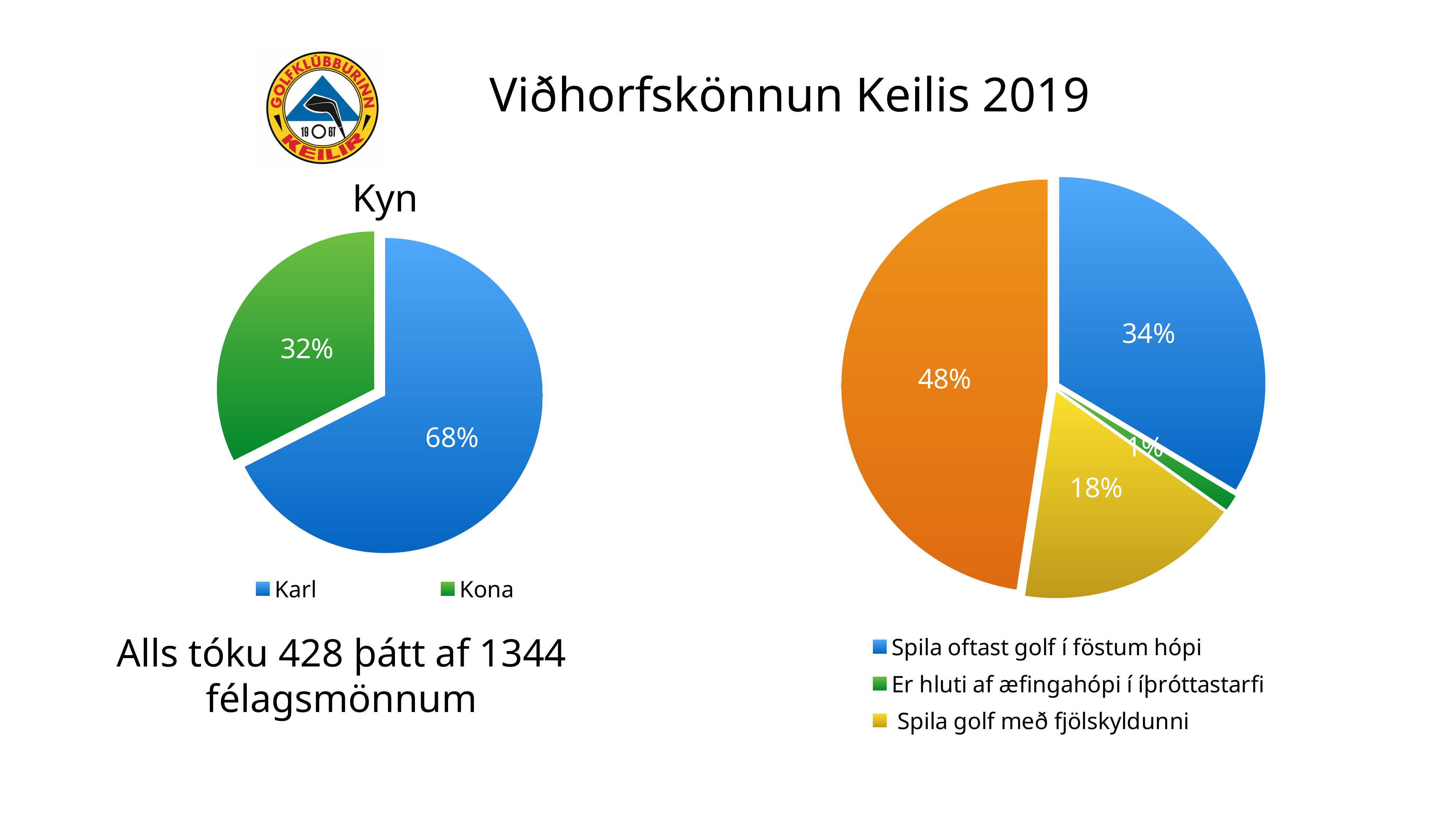
What kind of chart is the Kyn chart? Pie chart On the Kyn pie chart, which category has the larger share? Karl On the Kyn pie chart, what percentage is Karl? 68% On the right-hand pie chart, which of the legend categories has the smallest share? Er hluti af æfingahópi í íþróttastarfi On the Kyn pie chart, what is the difference in percentage points between Karl and Kona? 36 On the right-hand pie chart, what percentage is 'Spila oftast golf í föstum hópi'? 34% On the right-hand pie chart, what percentage is shown on the orange slice? 48% On the right-hand pie chart, what percentage is 'Spila golf með fjölskyldunni'? 18% How many entries does the legend of the Kyn chart list? 2 On the right-hand pie chart, what percentage is 'Er hluti af æfingahópi í íþróttastarfi'? 1% On the right-hand pie chart, how many slices are there? 4 On the Kyn pie chart, what percentage is Kona? 32%